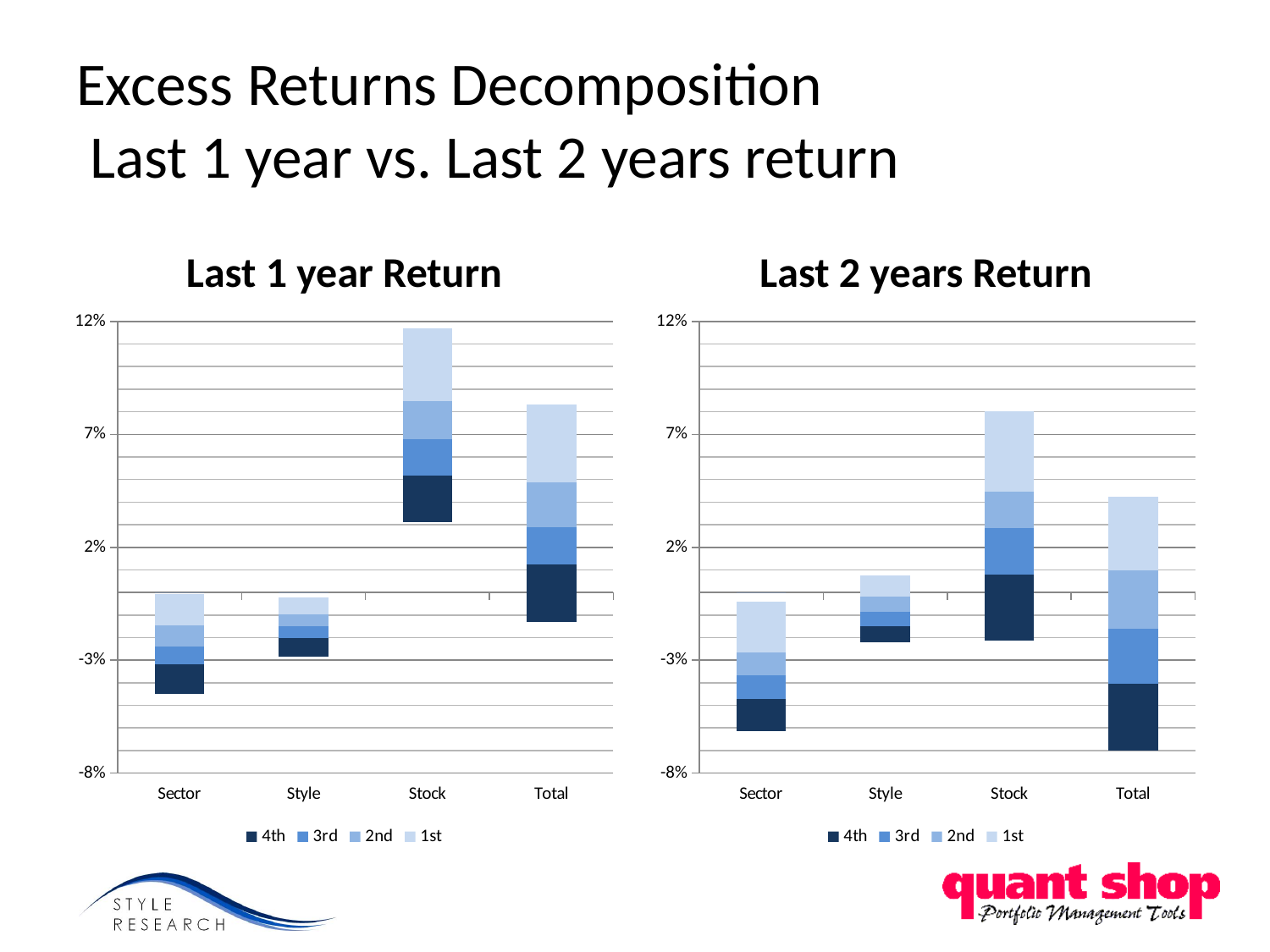
What are the legend entries of the "Last 2 years Return" chart? 4th, 3rd, 2nd, 1st In the "Last 1 year Return" chart, is the top of the Stock bar greater or less than 7%? greater In the "Last 2 years Return" chart, is the bottom of the Total bar greater or less than -3%? less Which chart's Stock bar reaches a higher value, "Last 1 year Return" or "Last 2 years Return"? Last 1 year Return In the "Last 2 years Return" chart, is the top of the Sector bar greater or less than 2%? less In the "Last 1 year Return" chart, which category's bar extends to the lowest value? Sector What kind of chart is the "Last 1 year Return" chart? Stacked bar chart In the "Last 2 years Return" chart, which category's bar extends to the lowest value? Total How many categories are shown on the x axis of the "Last 2 years Return" chart? 4 In the "Last 1 year Return" chart, which category's bar reaches the highest value? Stock How many series does the legend of the "Last 1 year Return" chart list? 4 What is the title of the chart on the right side of the slide? Last 2 years Return